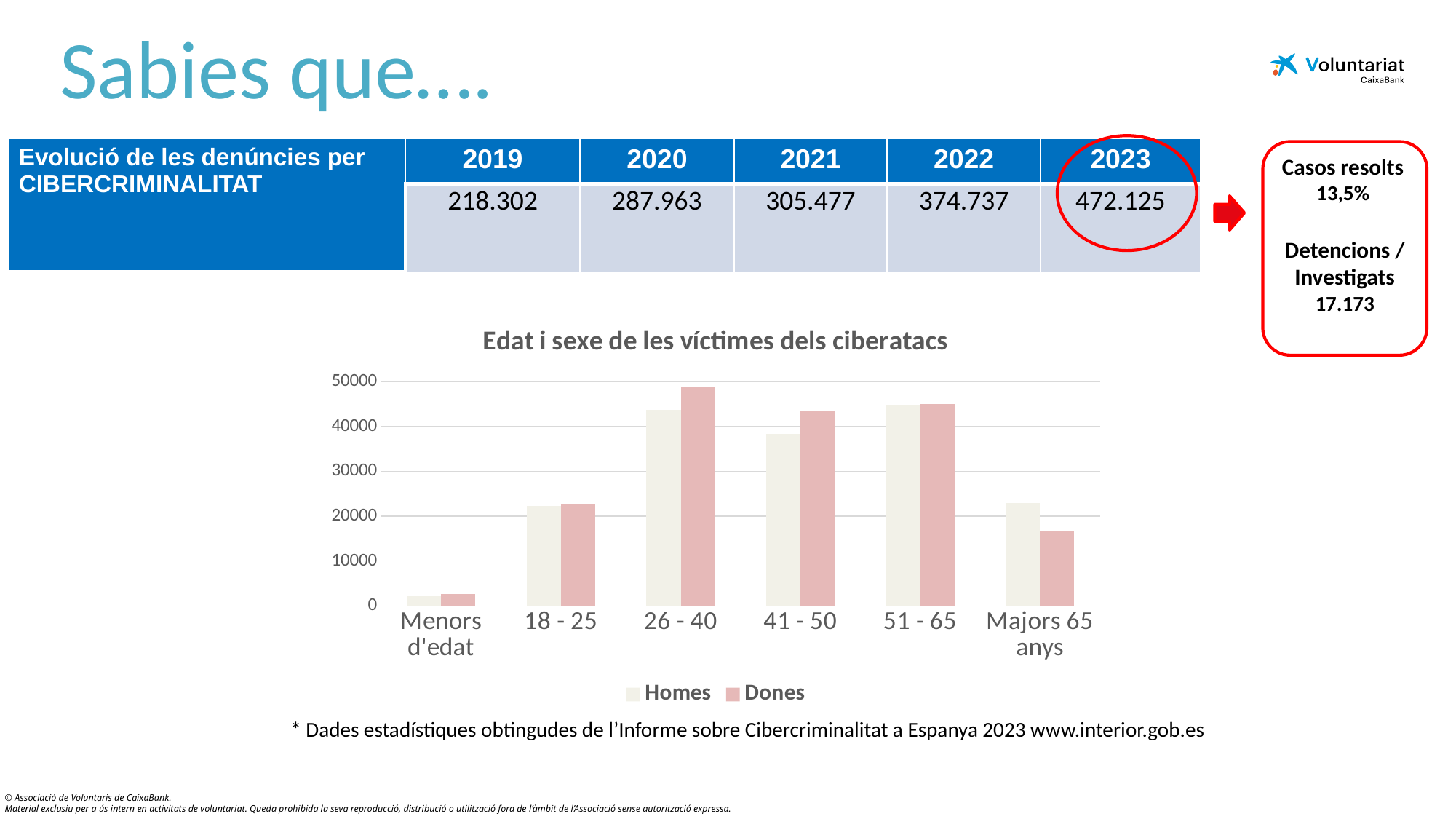
How many series does the legend of the chart "Edat i sexe de les víctimes dels ciberatacs" list? 2 In the chart "Edat i sexe de les víctimes dels ciberatacs", for Majors 65 anys, which series is larger, Homes or Dones? Homes How many age categories are shown on the x axis of the chart "Edat i sexe de les víctimes dels ciberatacs"? 6 In the chart "Edat i sexe de les víctimes dels ciberatacs", is the value for Dones in Majors 65 anys greater or less than 20000? less What are the two legend entries of the chart "Edat i sexe de les víctimes dels ciberatacs"? Homes, Dones In the chart "Edat i sexe de les víctimes dels ciberatacs", is the value for Homes in 41 - 50 greater or less than 40000? less What kind of chart is "Edat i sexe de les víctimes dels ciberatacs"? bar chart What is the title of the bar chart on the slide? Edat i sexe de les víctimes dels ciberatacs In the chart "Edat i sexe de les víctimes dels ciberatacs", for 41 - 50, which series is larger, Homes or Dones? Dones In the chart "Edat i sexe de les víctimes dels ciberatacs", which age category has the highest value for Dones? 26 - 40 In the chart "Edat i sexe de les víctimes dels ciberatacs", is the value for Dones in 26 - 40 greater or less than 40000? greater In the chart "Edat i sexe de les víctimes dels ciberatacs", which age category has the lowest value for Homes? Menors d'edat